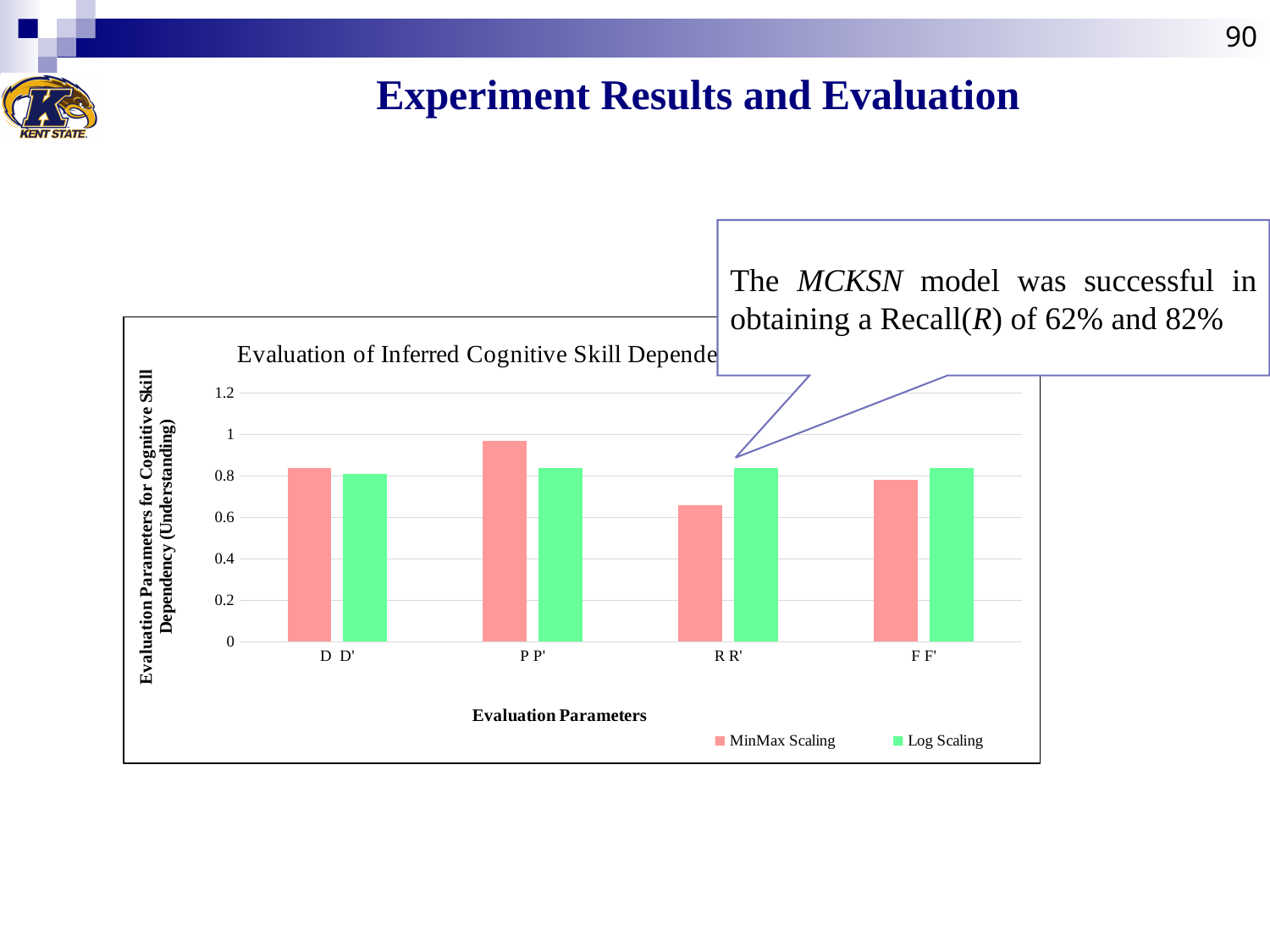
Which category has the highest MinMax Scaling bar? P P' Is the MinMax Scaling value for P P' greater or less than 0.8? greater What are the two series named in the chart's legend? MinMax Scaling and Log Scaling What kind of chart is shown on the slide? bar chart How many categories are shown on the x axis of the chart? 4 For P P', which series has the larger value, MinMax Scaling or Log Scaling? MinMax Scaling How many series does the chart's legend list? 2 What is the title of the x axis of the chart? Evaluation Parameters Is the MinMax Scaling value for R R' greater or less than 0.8? less Which category has the lowest MinMax Scaling bar? R R' For R R', which series has the larger value, MinMax Scaling or Log Scaling? Log Scaling Is the MinMax Scaling value for R R' greater or less than 0.6? greater